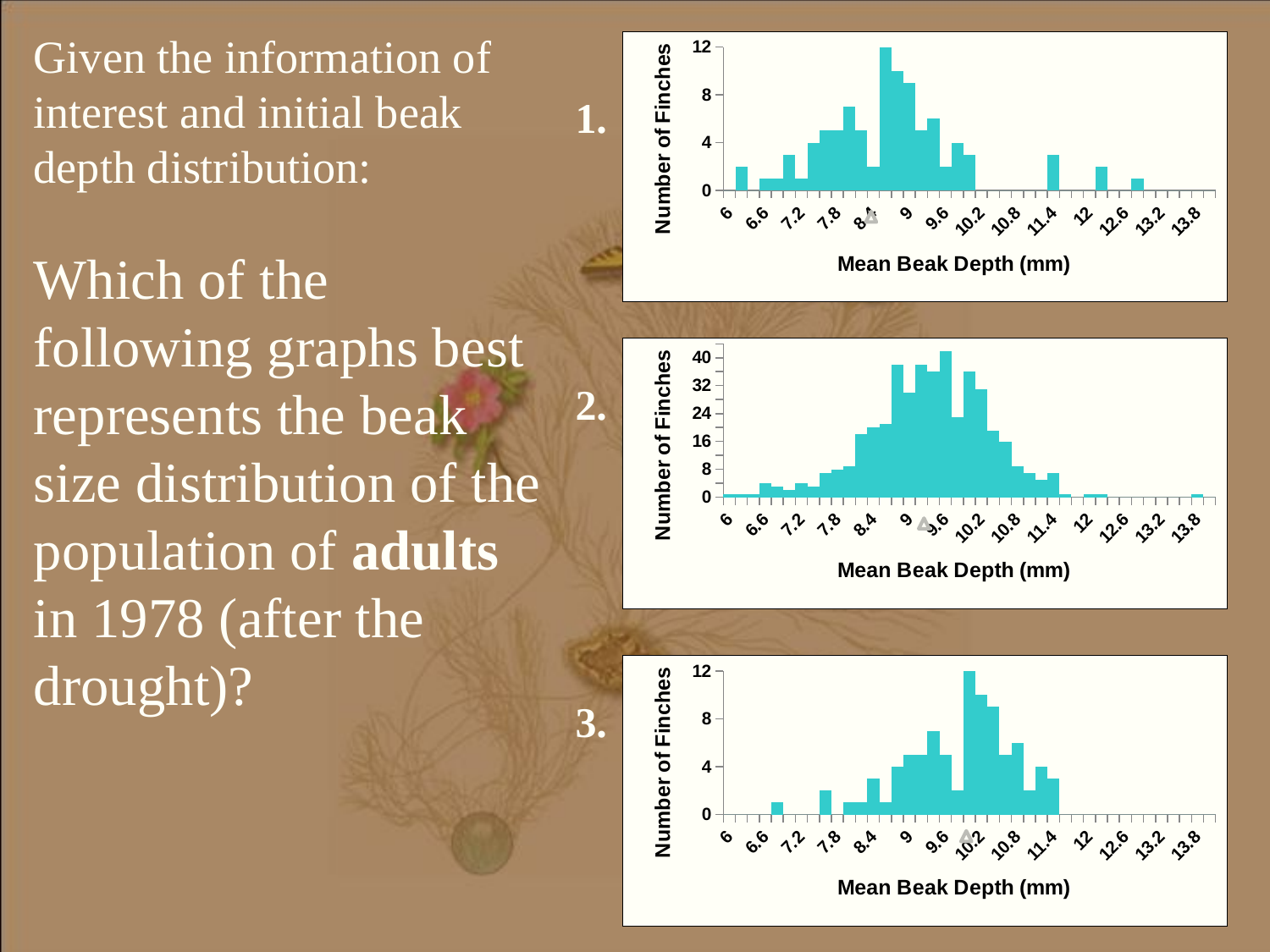
What is the x-axis title of chart 3 (the bottom chart)? Mean Beak Depth (mm) In chart 3 (the bottom chart), is the value for the bar at 9.6 greater or less than 4? greater In chart 3 (the bottom chart), is the value for the bar at 6.6 greater or less than 4? less In chart 1 (the top chart), is the value for the bar at 7.8 greater or less than 4? greater What is the y-axis title of chart 2 (the middle chart)? Number of Finches What kind of chart is chart 1 (the top chart)? bar chart In chart 1 (the top chart), which bar is taller: the one at 9 or the one at 11.4? 9